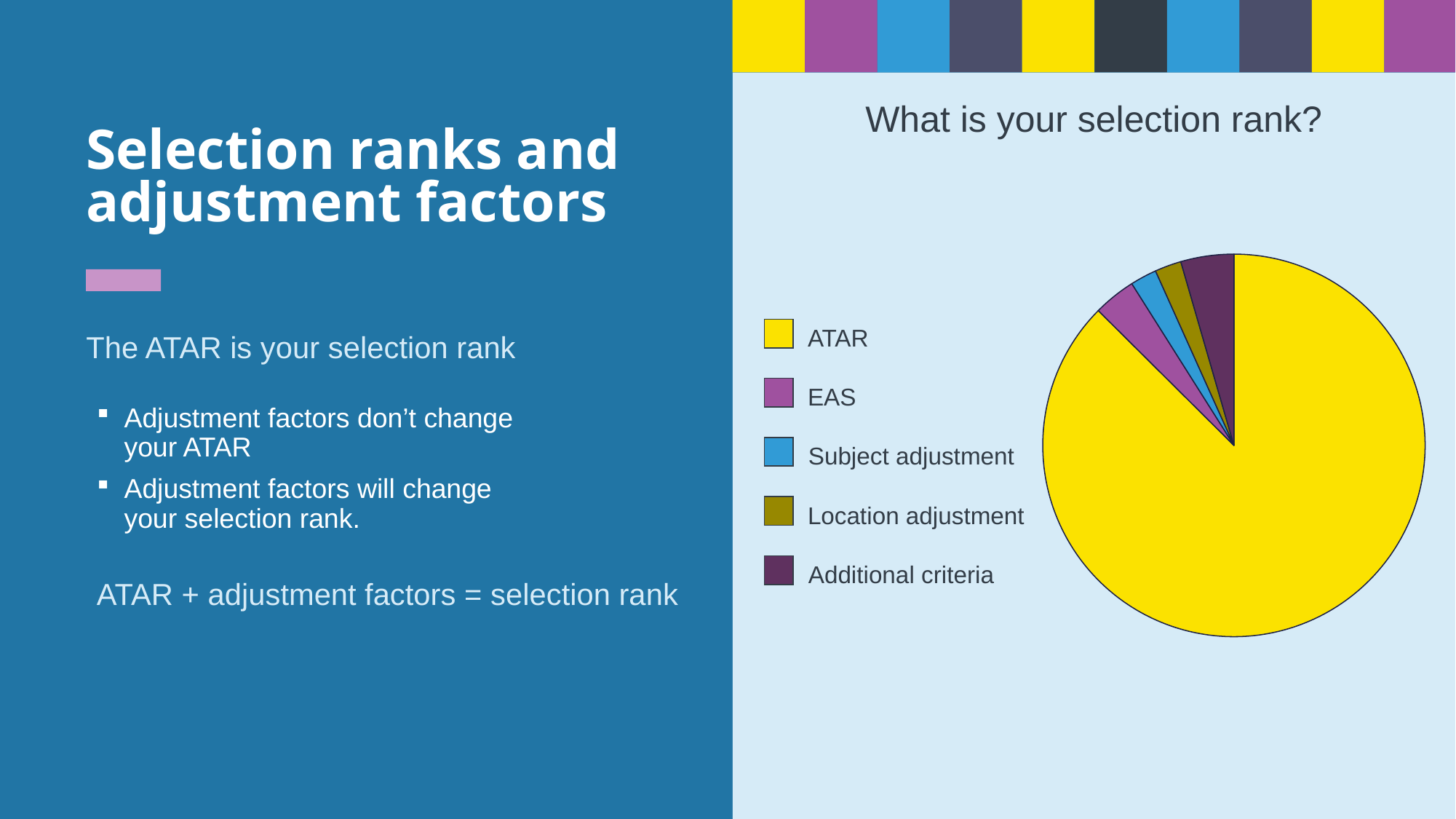
Which is larger in the pie chart, the Additional criteria slice or the EAS slice? Additional criteria What is the title of the chart? What is your selection rank? How many categories does the pie chart's legend list? 5 Does the ATAR slice take up more or less than half of the pie chart? more What kind of chart is shown on the slide? pie chart Which category has the largest slice of the pie chart? ATAR Which is larger in the pie chart, the ATAR slice or the Additional criteria slice? ATAR Which is larger in the pie chart, the ATAR slice or the EAS slice? ATAR Which colour represents ATAR in the pie chart? yellow How many slices does the pie chart have? 5